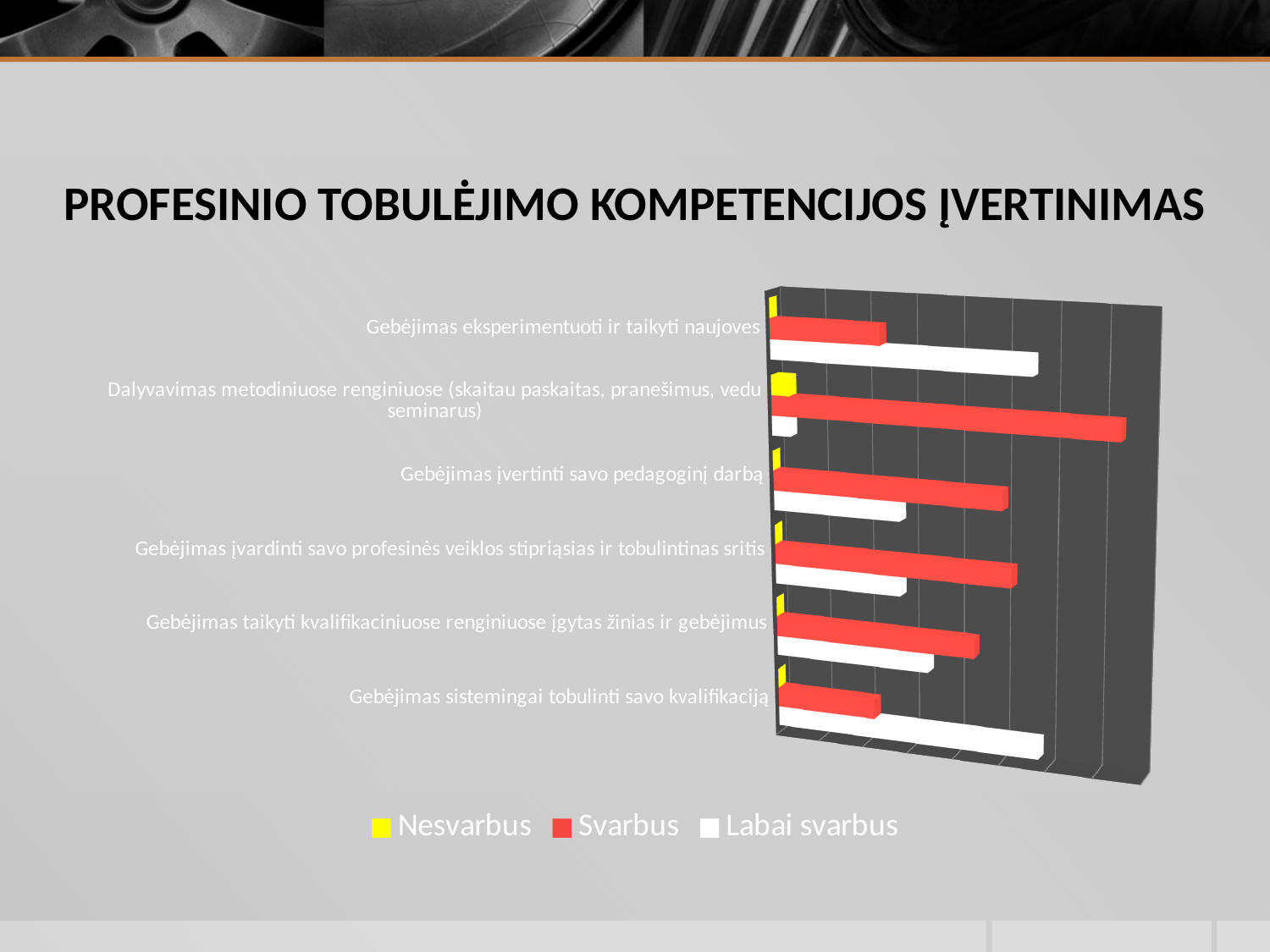
How many categories are plotted on the chart? 6 Which colour represents the Nesvarbus series in the legend? Yellow For 'Dalyvavimas metodiniuose renginiuose', which is larger: Svarbus or Labai svarbus? Svarbus What is the title of the slide containing the chart? PROFESINIO TOBULĖJIMO KOMPETENCIJOS ĮVERTINIMAS How many series does the legend list? 3 Which category has the longest Svarbus bar? Dalyvavimas metodiniuose renginiuose (skaitau paskaitas, pranešimus, vedu seminarus) What kind of chart is shown on the slide? Bar chart For 'Gebėjimas sistemingai tobulinti savo kvalifikaciją', which is larger: Svarbus or Labai svarbus? Labai svarbus Which category has the shortest Labai svarbus bar? Dalyvavimas metodiniuose renginiuose (skaitau paskaitas, pranešimus, vedu seminarus) For 'Gebėjimas įvertinti savo pedagoginį darbą', which is larger: Svarbus or Labai svarbus? Svarbus Which category has the longest Nesvarbus bar? Dalyvavimas metodiniuose renginiuose (skaitau paskaitas, pranešimus, vedu seminarus)